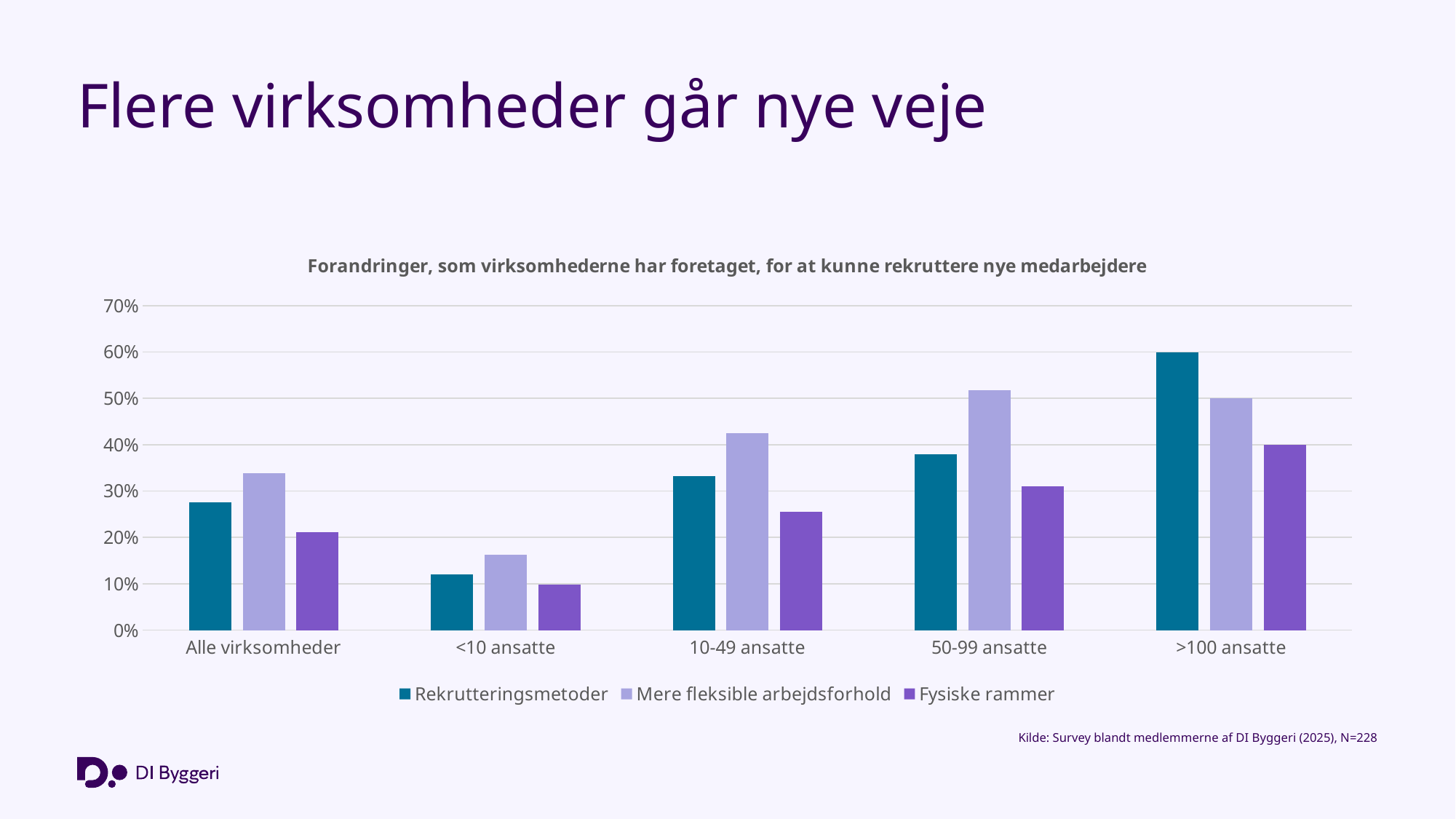
How many categories are shown on the x axis of the chart? 5 Which category has the lowest value for Fysiske rammer? <10 ansatte Is the value for Mere fleksible arbejdsforhold in the 50-99 ansatte category greater or less than 40%? greater What kind of chart is shown on the slide? Bar chart How many series does the chart's legend list? 3 For Alle virksomheder, which is larger: Rekrutteringsmetoder or Mere fleksible arbejdsforhold? Mere fleksible arbejdsforhold Is the value for Fysiske rammer in the <10 ansatte category greater or less than 20%? less Is the value for Rekrutteringsmetoder in the 10-49 ansatte category greater or less than 30%? greater Which category has the highest value for Rekrutteringsmetoder? >100 ansatte What is the title of the chart? Forandringer, som virksomhederne har foretaget, for at kunne rekruttere nye medarbejdere Do the values for Fysiske rammer rise or fall from <10 ansatte to >100 ansatte? rise For >100 ansatte, which is larger: Rekrutteringsmetoder or Fysiske rammer? Rekrutteringsmetoder